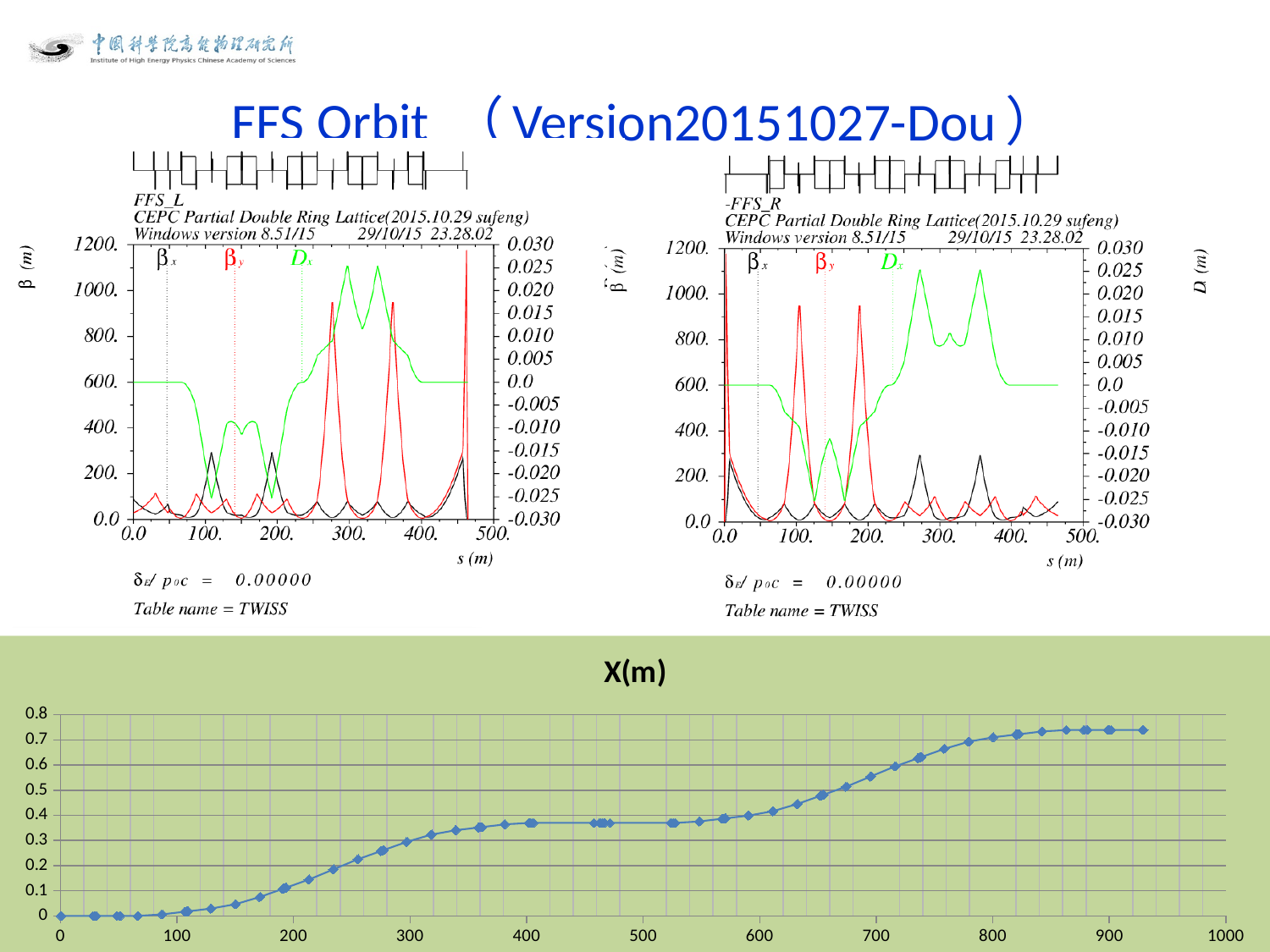
In the bottom chart titled "X(m)", is the value at x = 700 greater or less than 0.5? greater How many series are labelled in the top-left chart (FFS_L)? 3 In the bottom chart titled "X(m)", is the value at x = 400 greater or less than 0.4? less In the bottom chart titled "X(m)", is the value at x = 100 greater or less than 0.1? less What is the highest value shown on the y axis of the bottom chart titled "X(m)"? 0.8 What kind of chart is the top-left chart (FFS_L)? line chart In the bottom chart titled "X(m)", which is larger, the value at x = 300 or the value at x = 800? x = 800 What is the maximum value shown on the left y axis of the top-right chart (FFS_R)? 1200. In the bottom chart titled "X(m)", do the values generally rise or fall as the x axis increases from 0 to 900? rise What kind of chart is the bottom chart titled "X(m)"? line chart